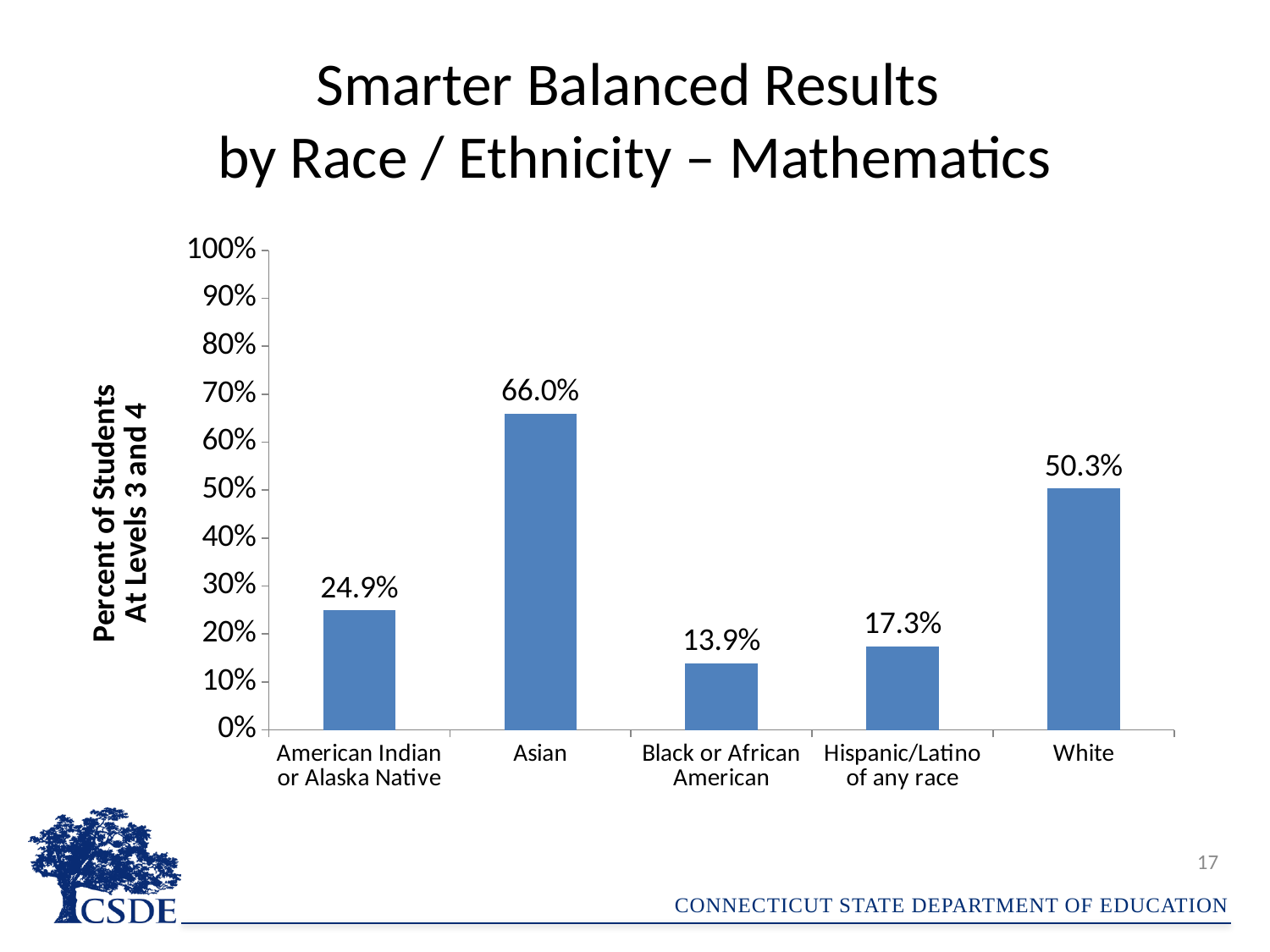
Which is larger, the value for American Indian or Alaska Native or the value for Hispanic/Latino of any race? American Indian or Alaska Native How many race/ethnicity categories are shown in the chart? 5 What is the difference between the American Indian or Alaska Native and Hispanic/Latino of any race values? 7.6% Which race/ethnicity group has the highest percent of students at Levels 3 and 4? Asian What is the value for Hispanic/Latino of any race? 17.3% What type of chart is shown on the slide? Bar chart What is the value for Black or African American students? 13.9% What percent of Asian students are at Levels 3 and 4 in Mathematics? 66.0% Which race/ethnicity group has the lowest percent of students at Levels 3 and 4? Black or African American What is the value for White students? 50.3% Is the value for White greater or less than 40%? greater What is the difference between the Asian and White values? 15.7%